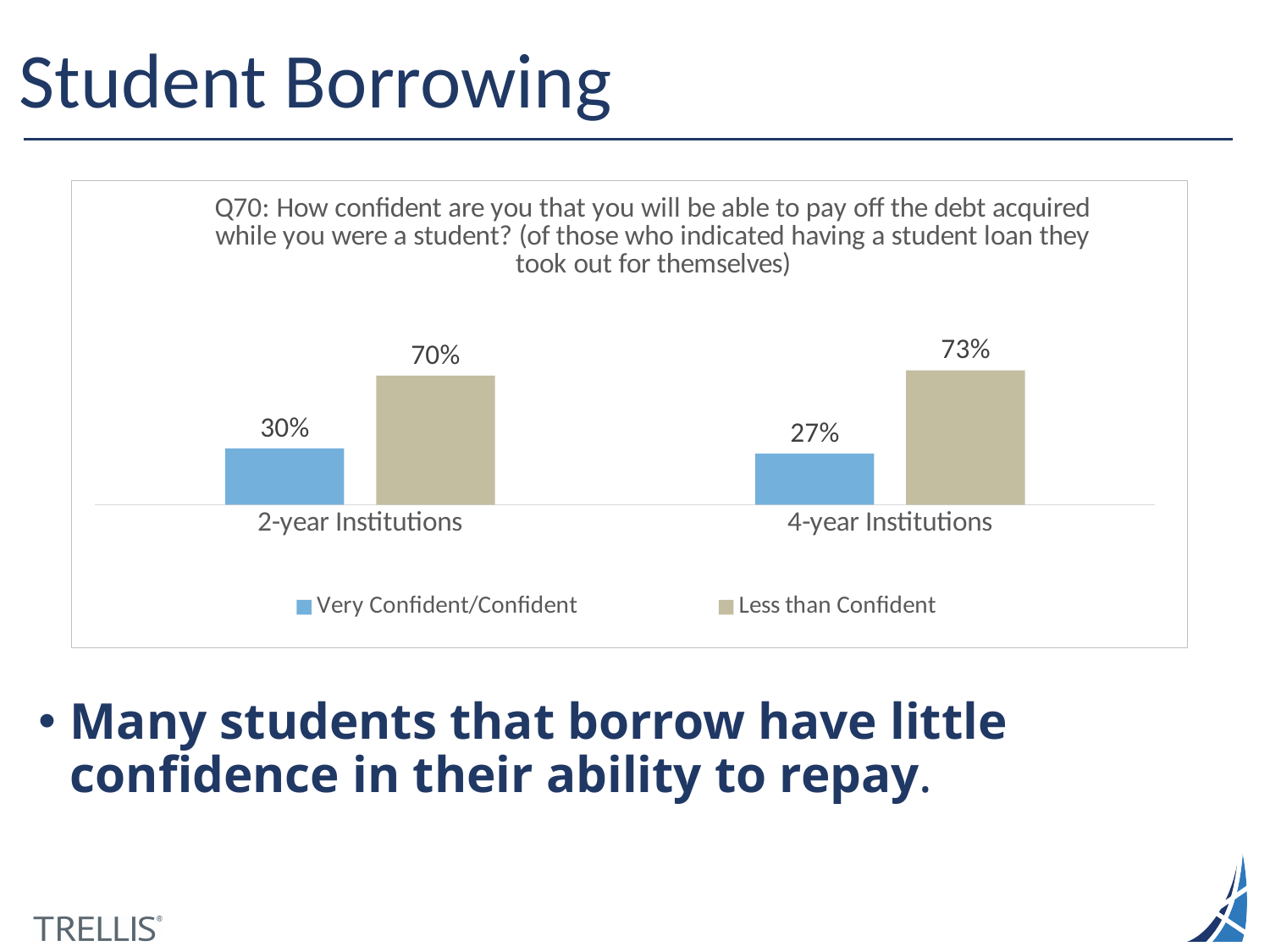
How many institution categories are shown on the x axis? 2 Is the Very Confident/Confident value for 2-year Institutions larger or smaller than the Less than Confident value for 2-year Institutions? smaller Which institution type has the higher Less than Confident percentage? 4-year Institutions What is the difference between the Less than Confident and Very Confident/Confident percentages at 2-year Institutions? 40 percentage points What percentage of respondents at 4-year Institutions are Very Confident/Confident? 27% How many series does the legend list? 2 What percentage of respondents at 2-year Institutions are Very Confident/Confident? 30% What percentage of respondents at 4-year Institutions are Less than Confident? 73% What percentage of respondents at 2-year Institutions are Less than Confident? 70% What kind of chart is shown on the slide? bar chart What is the difference in the Very Confident/Confident percentage between 2-year Institutions and 4-year Institutions? 3 percentage points Which institution type has the lower Very Confident/Confident percentage? 4-year Institutions